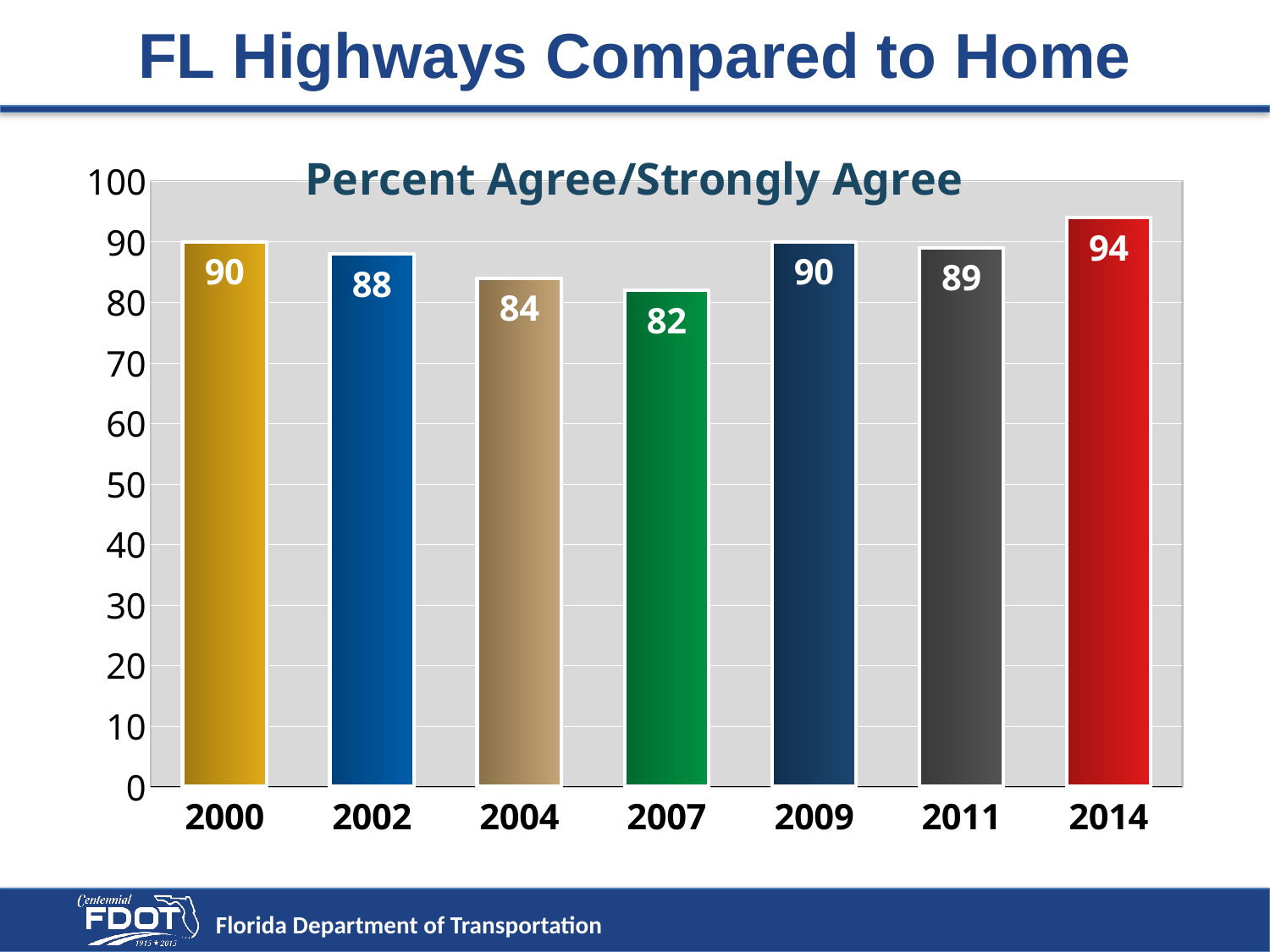
Which year has the highest value? 2014 What is the value for 2007? 82 Which year has the lowest value? 2007 What kind of chart is shown on the slide? bar chart How many years are shown on the x axis? 7 What is the value for 2004? 84 Is the value for 2009 greater or less than 50? greater What is the difference between the values for 2014 and 2007? 12 What is the title of the chart? Percent Agree/Strongly Agree What is the difference between the values for 2002 and 2004? 4 What is the value for 2014? 94 Which is larger, the value for 2011 or the value for 2007? 2011